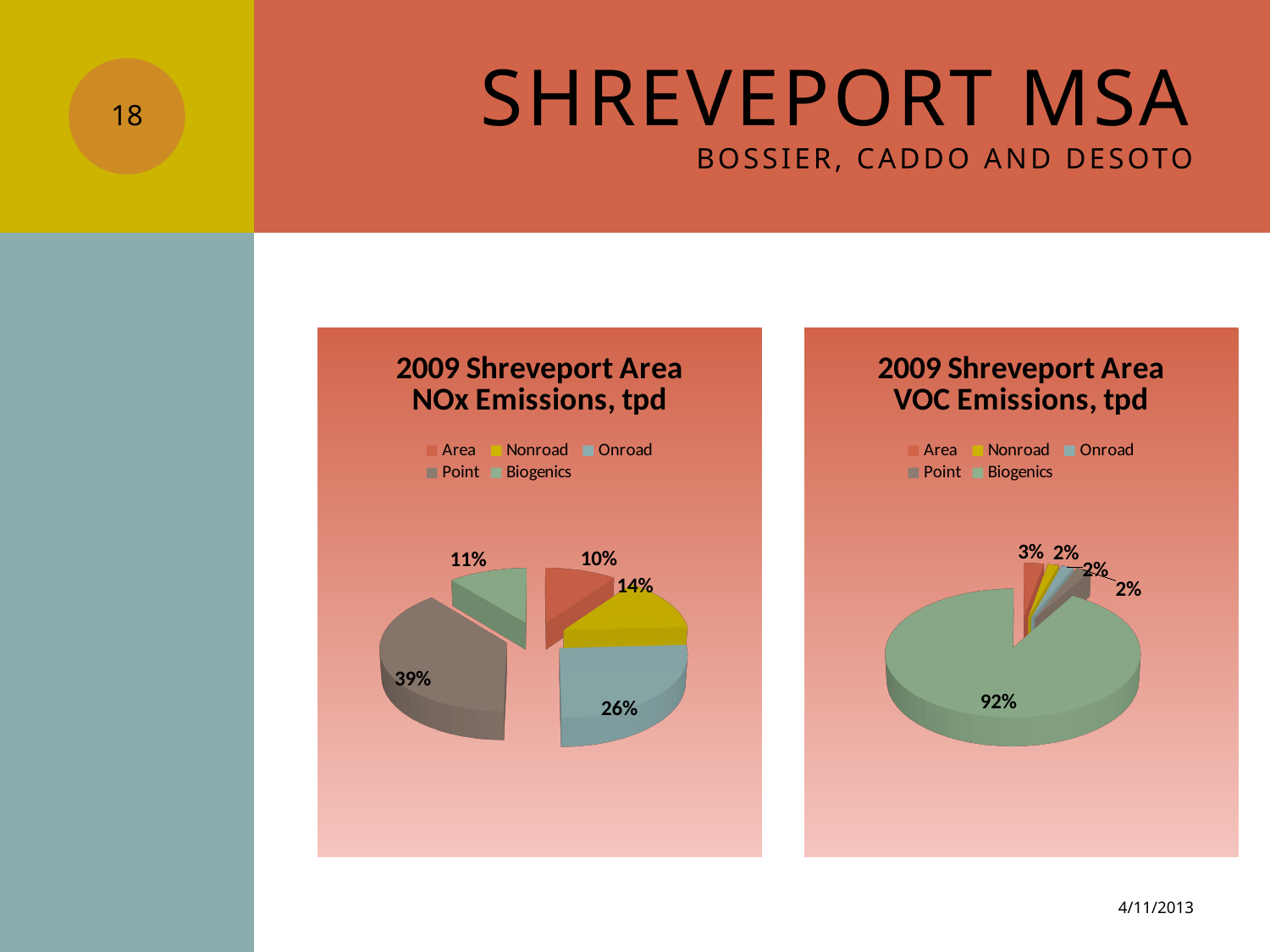
In the 2009 Shreveport Area VOC Emissions chart, what share of emissions comes from Area sources? 3% In the 2009 Shreveport Area NOx Emissions chart, what share of emissions comes from Onroad sources? 26% How many categories does the legend of the 2009 Shreveport Area VOC Emissions chart list? 5 In the 2009 Shreveport Area NOx Emissions chart, which category has the smallest share? Area What type of chart is the 2009 Shreveport Area NOx Emissions chart? Pie chart In the 2009 Shreveport Area VOC Emissions chart, what share of emissions comes from Biogenics? 92% In the 2009 Shreveport Area NOx Emissions chart, what share of emissions comes from Biogenics? 11% In the 2009 Shreveport Area NOx Emissions chart, which category has the largest share? Point In the 2009 Shreveport Area NOx Emissions chart, what is the difference in percentage points between the Point share and the Onroad share? 13 In the 2009 Shreveport Area VOC Emissions chart, which category has the largest share? Biogenics In the 2009 Shreveport Area NOx Emissions chart, which is larger, the Nonroad share or the Biogenics share? Nonroad In the 2009 Shreveport Area NOx Emissions chart, what share of emissions comes from Point sources? 39%